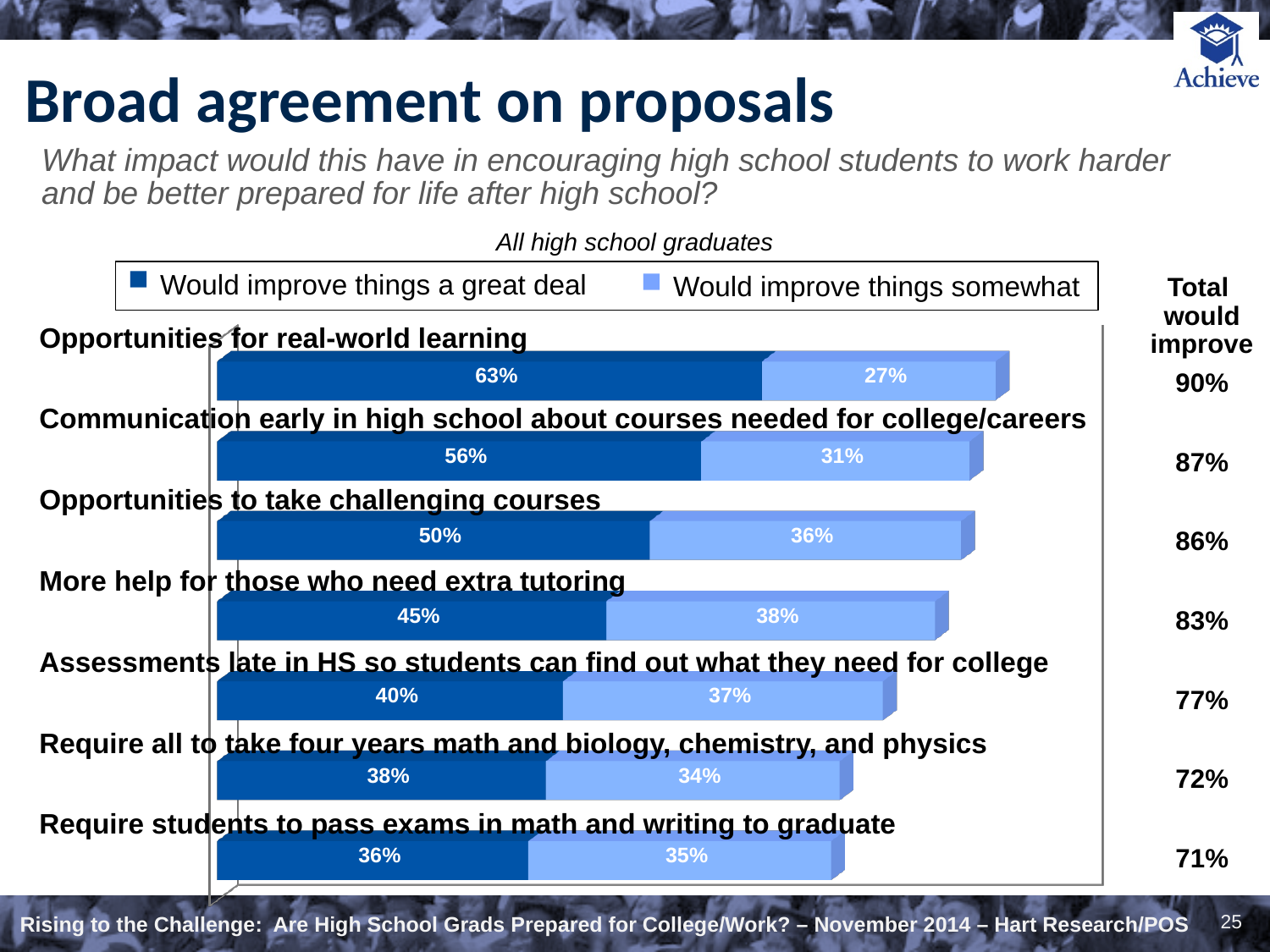
Which is larger: the 'would improve things somewhat' share for more help for those who need extra tutoring or for opportunities for real-world learning? More help for those who need extra tutoring What is the difference between the 'great deal' percentages for opportunities to take challenging courses and more help for those who need extra tutoring? 5% What is the total 'would improve' percentage for requiring all to take four years math and biology, chemistry, and physics? 72% What is the total 'would improve' percentage for communication early in high school about courses needed for college/careers? 87% What percentage say requiring students to pass exams in math and writing to graduate would improve things somewhat? 35% Which proposal has the lowest share saying it would improve things a great deal? Require students to pass exams in math and writing to graduate Which group of respondents does the chart cover, according to the label above the legend? All high school graduates What percentage of high school graduates say opportunities for real-world learning would improve things a great deal? 63% What kind of chart is shown on the slide? Stacked bar chart Which proposal has the highest share saying it would improve things a great deal? Opportunities for real-world learning How many proposals are shown in the chart? 7 How many series does the legend list? 2